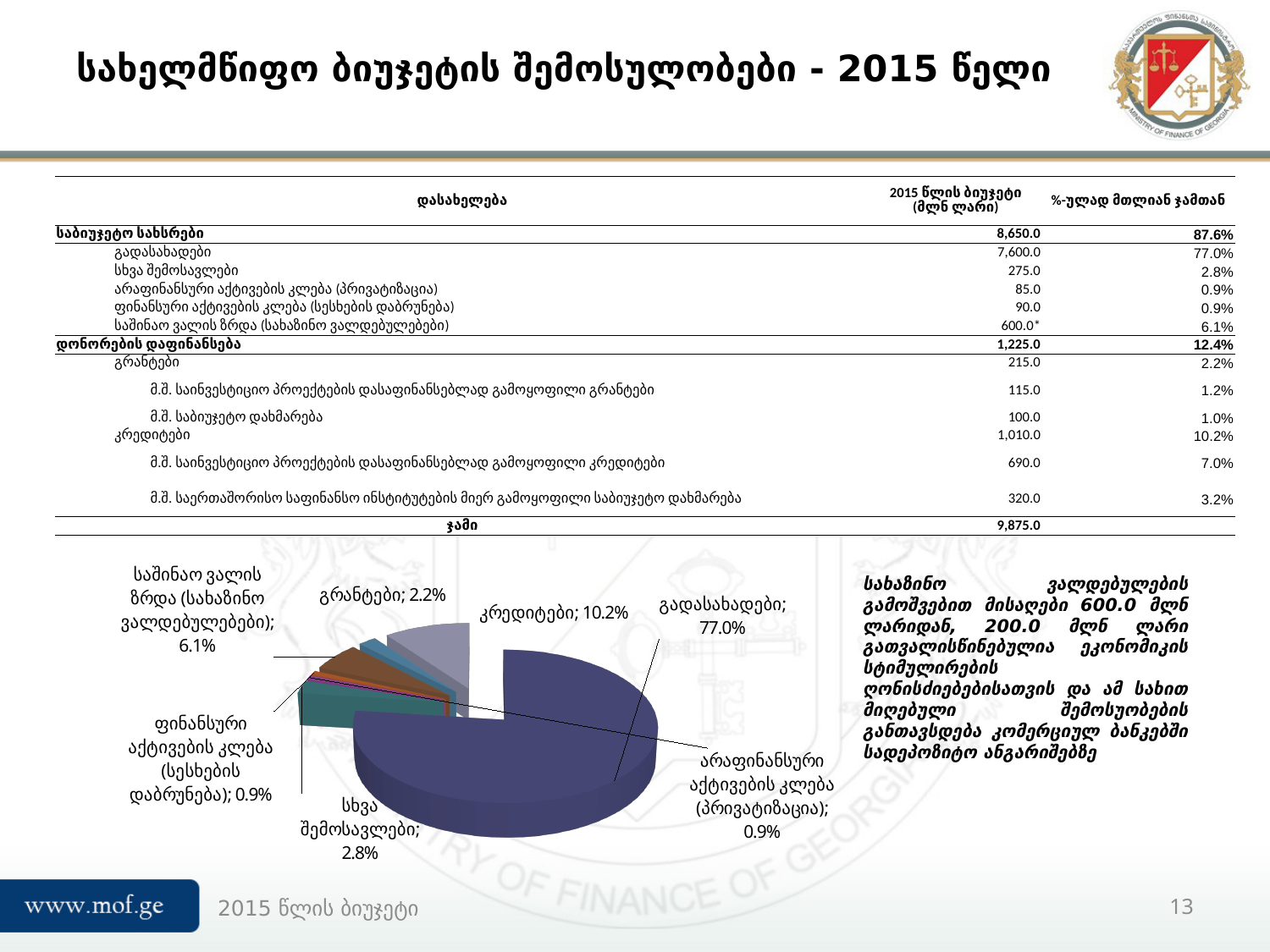
What is the difference in percentage points between the გადასახადები slice and the კრედიტები slice? 66.8 What share of the pie does არაფინანსური აქტივების კლება (პრივატიზაცია) hold? 0.9% What is the difference in percentage points between the სხვა შემოსავლები slice and the გრანტები slice? 0.6 What share of the pie does საშინაო ვალის ზრდა (სახაზინო ვალდებულებები) hold? 6.1% Which slice of the pie chart is the largest? გადასახადები How many slices does the pie chart have? 7 What share of the pie does სხვა შემოსავლები hold? 2.8% What kind of chart is shown on the slide? pie chart Which is larger in the pie chart, კრედიტები or საშინაო ვალის ზრდა (სახაზინო ვალდებულებები)? კრედიტები